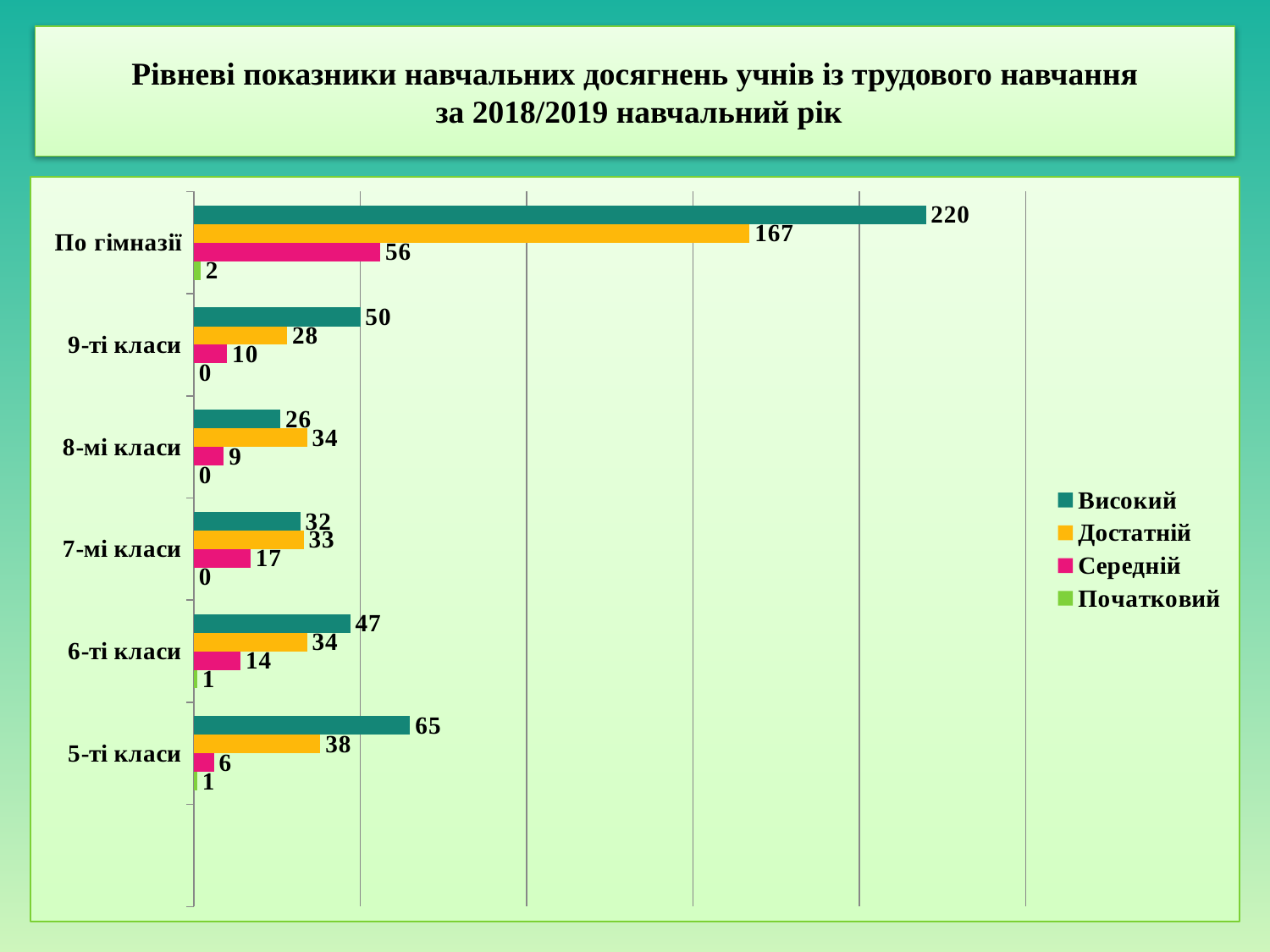
What type of chart is shown on the slide? bar chart Which series is shown in pink in the legend? Середній Among the class groups (excluding По гімназії), which category has the highest Високий value? 5-ті класи Among the class groups (excluding По гімназії), which category has the lowest Високий value? 8-мі класи What is the value of Достатній for 5-ті класи? 38 How many series does the legend list? 4 What is the value of Початковий for 6-ті класи? 1 What is the difference between the Високий and Достатній values for По гімназії? 53 What is the value of Високий for По гімназії? 220 Which is larger for 8-мі класи: the Високий value or the Достатній value? Достатній What is the value of Середній for 7-мі класи? 17 How many categories are shown on the vertical axis? 6